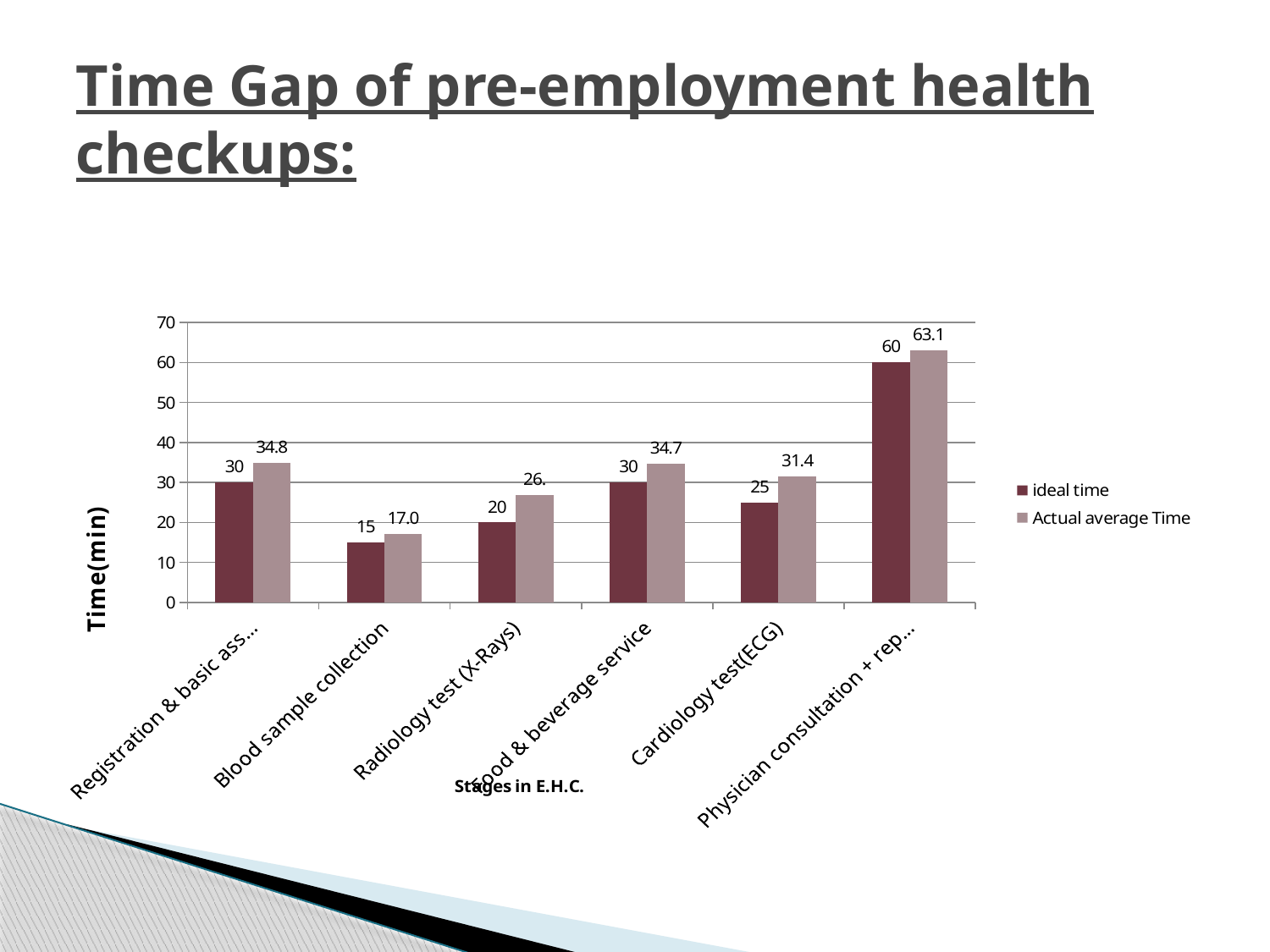
How many series does the legend list? 2 How much greater is the Actual average Time than the ideal time for Cardiology test(ECG)? 6.4 Which has a larger ideal time, Blood sample collection or Radiology test (X-Rays)? Radiology test (X-Rays) What is the ideal time for Cardiology test(ECG)? 25 What is the Actual average Time for Cardiology test(ECG)? 31.4 Which stage has the highest Actual average Time? Physician consultation + rep… How many stages are shown on the x axis? 6 What is the difference between the Actual average Time and the ideal time for Food & beverage service? 4.7 What is the Actual average Time for Food & beverage service? 34.7 Which stage has the lowest ideal time? Blood sample collection What is the ideal time for Blood sample collection? 15 Is the Actual average Time for Radiology test (X-Rays) greater or less than 30? less